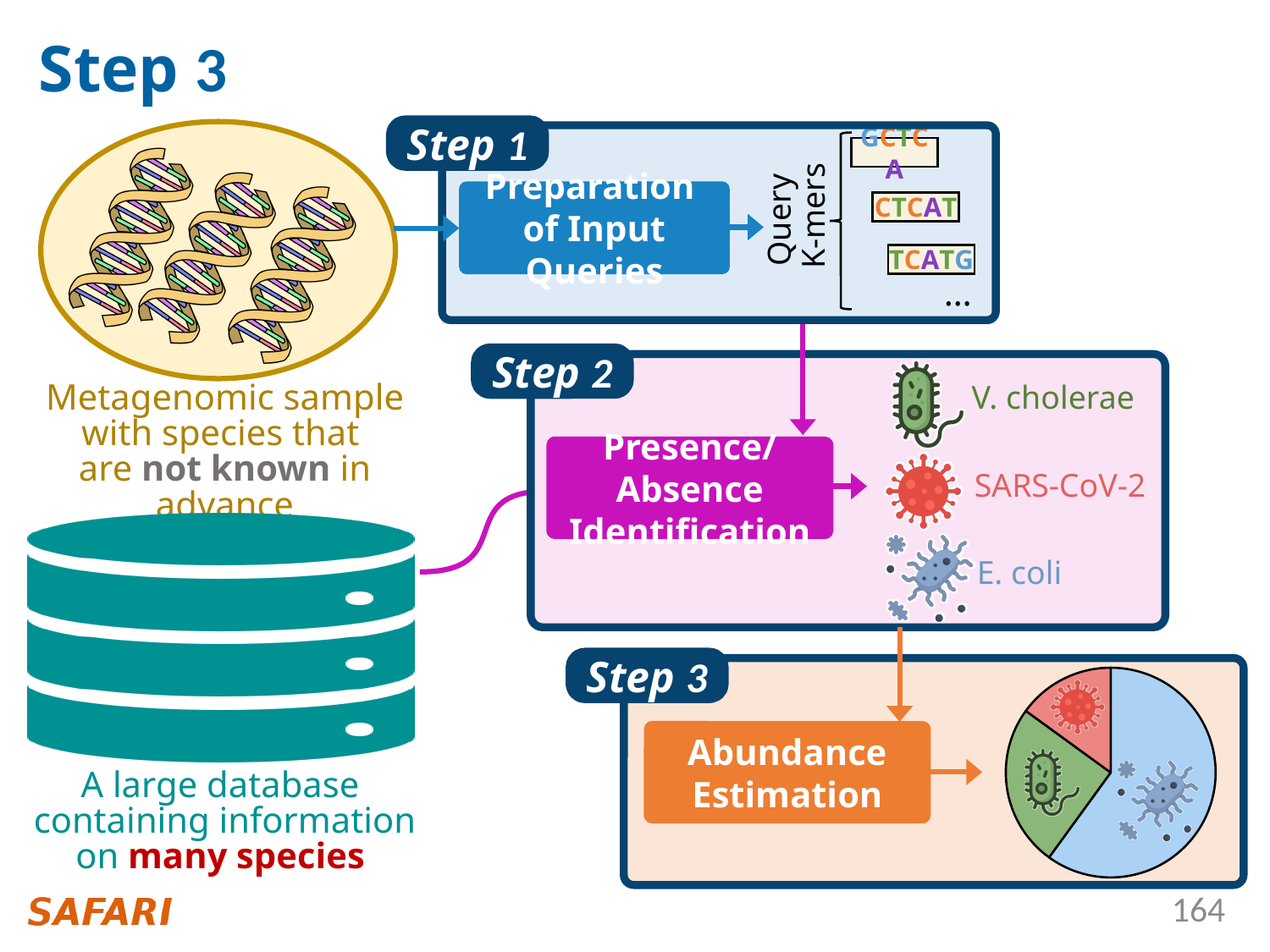
What kind of chart is shown in the Step 3 box? pie chart What colour is the slice containing the bacterium icon (V. cholerae) in the Step 3 pie chart? green In the Step 3 pie chart, is the green (V. cholerae) slice larger or smaller than the blue (E. coli) slice? smaller Which process box feeds into the pie chart in the Step 3 box? Abundance Estimation In the Step 3 pie chart, is the blue (E. coli) slice larger or smaller than the red (SARS-CoV-2) slice? larger In the Step 3 pie chart, which slice is the smallest? the red slice (SARS-CoV-2) In the Step 3 pie chart, which slice is the largest? the blue slice (E. coli) How many slices does the pie chart in the Step 3 box have? 3 In the Step 3 pie chart, does the blue (E. coli) slice take up more or less than half of the pie? more